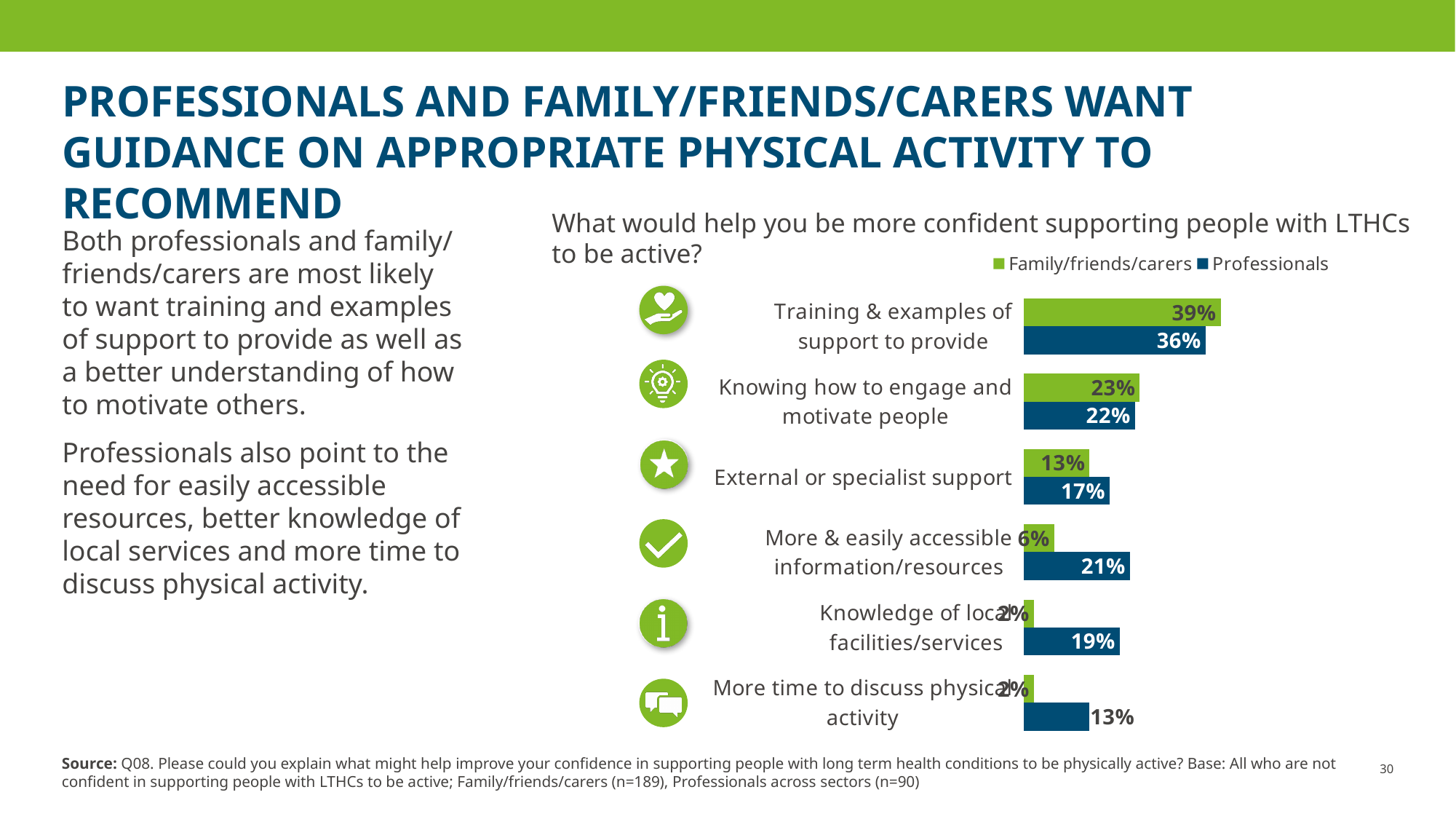
What is the Professionals value for 'More & easily accessible information/resources'? 21% How many series does the chart legend list? 2 Which series is shown in green in the chart? Family/friends/carers What kind of chart is shown on the slide? bar chart What is the Family/friends/carers value for 'Training & examples of support to provide'? 39% How many categories are shown in the chart? 6 What is the Family/friends/carers value for 'External or specialist support'? 13% Which category has the highest Professionals value? Training & examples of support to provide What is the Professionals value for 'Knowledge of local facilities/services'? 19% What is the difference between the Family/friends/carers and Professionals values for 'More & easily accessible information/resources'? 15% For 'External or specialist support', which series has the larger value, Family/friends/carers or Professionals? Professionals Which category has the lowest Professionals value? More time to discuss physical activity